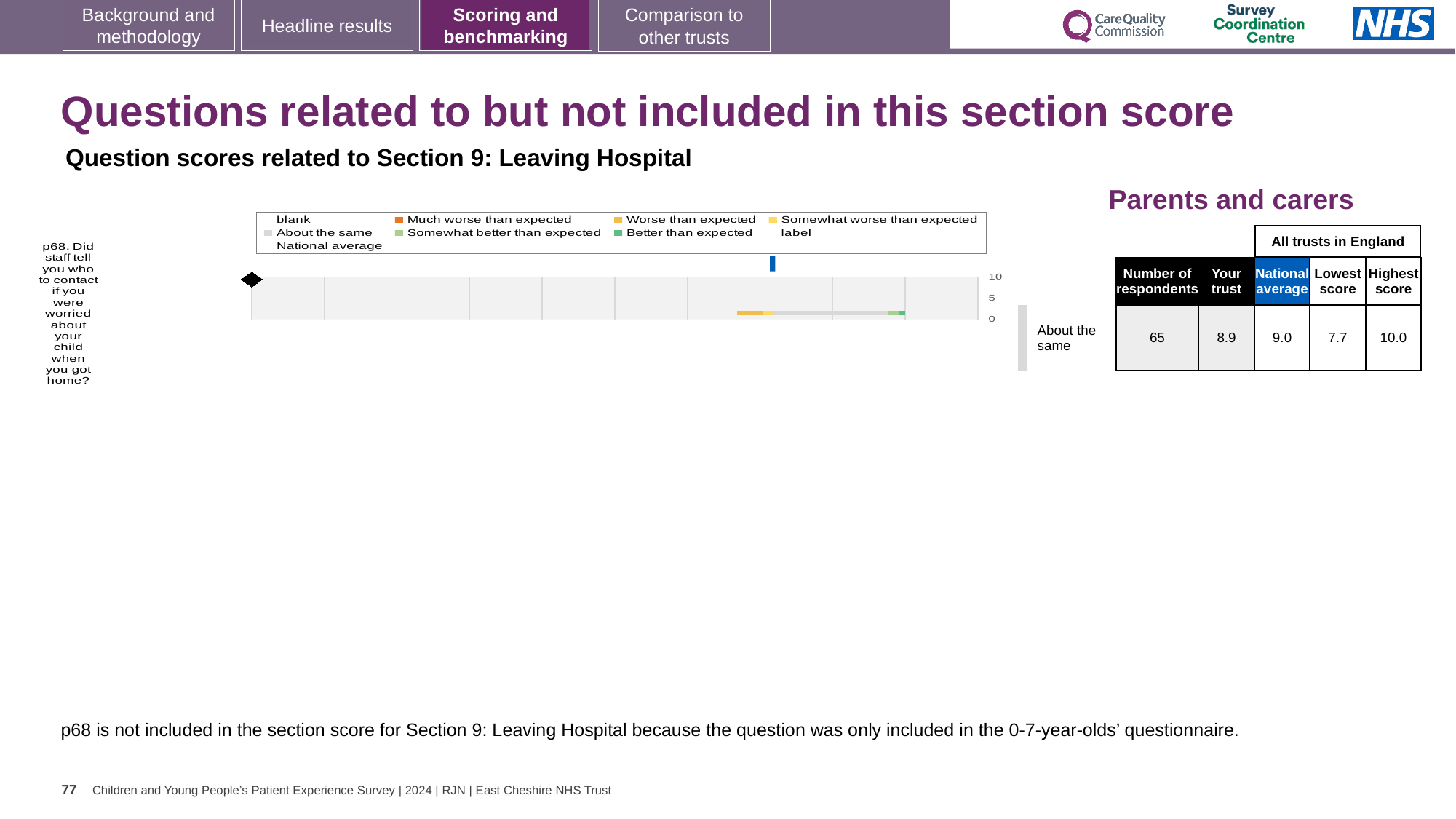
What is the 'Your trust' score for p68? 8.9 How many questions are plotted in the chart? 1 What is the highest score among all trusts in England for p68? 10.0 What is the difference between the highest and lowest scores for p68 across all trusts in England? 2.3 Which legend entry is shown in orange? Much worse than expected How many respondents answered p68? 65 What is the national average score for p68? 9.0 Which is larger for p68, the 'Your trust' score or the national average? national average What kind of chart is used to show the p68 question score? bar chart What is the highest value shown on the chart's score axis? 10 How is the trust's result for p68 categorised relative to expectations? About the same What is the lowest score among all trusts in England for p68? 7.7